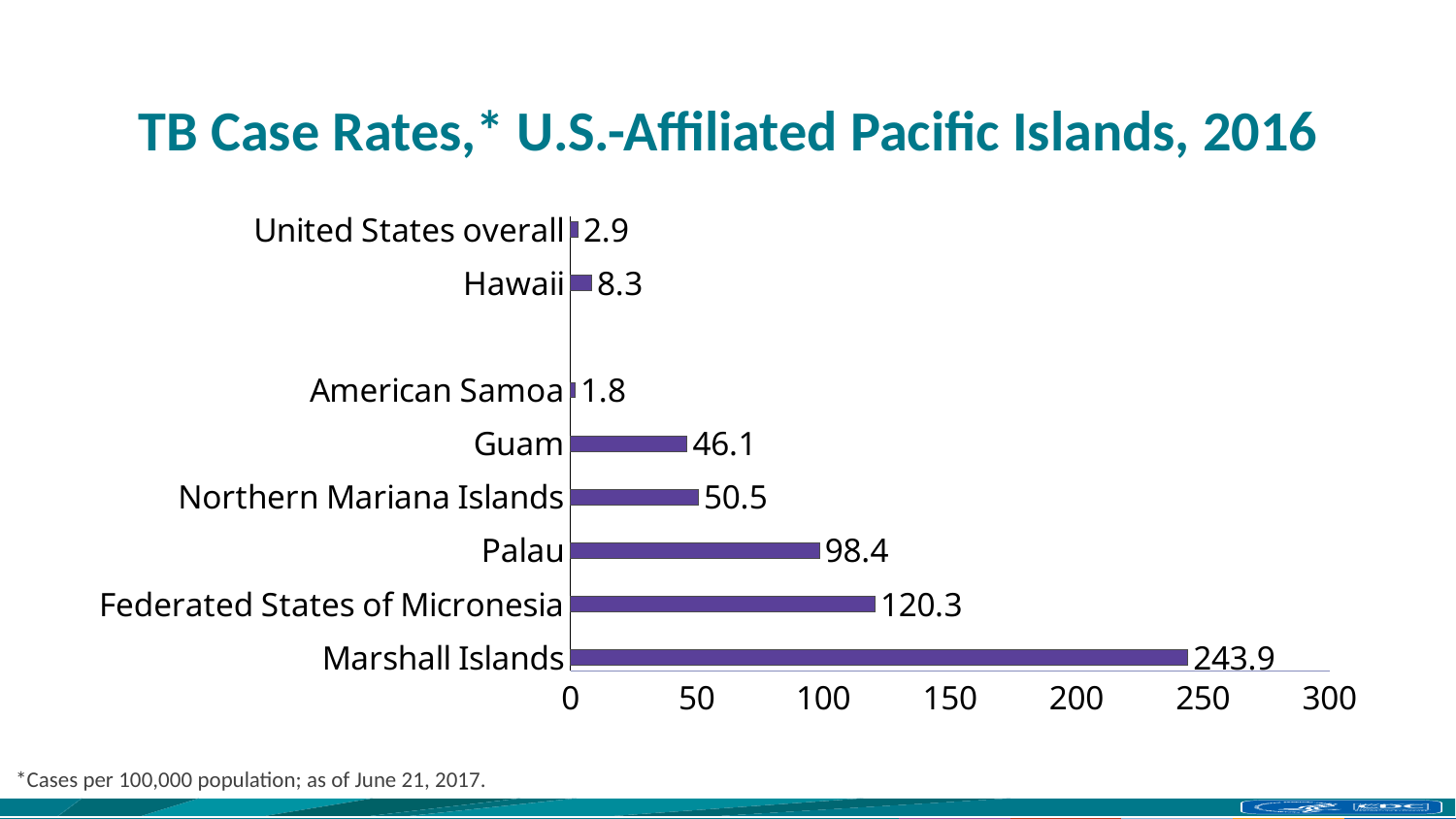
Which category has the lowest TB case rate? American Samoa Is the value for the Federated States of Micronesia greater or less than 100? greater What is the difference between the TB case rates of the Marshall Islands and the Federated States of Micronesia? 123.6 What is the TB case rate for the United States overall? 2.9 What is the TB case rate for Guam? 46.1 How many categories are shown in the chart? 8 What is the TB case rate for the Marshall Islands? 243.9 What is the difference between the TB case rates of the Northern Mariana Islands and Guam? 4.4 Which category has the highest TB case rate? Marshall Islands Which has a higher TB case rate, Palau or Hawaii? Palau What is the title of the chart? TB Case Rates,* U.S.-Affiliated Pacific Islands, 2016 What kind of chart is shown on the slide? Bar chart